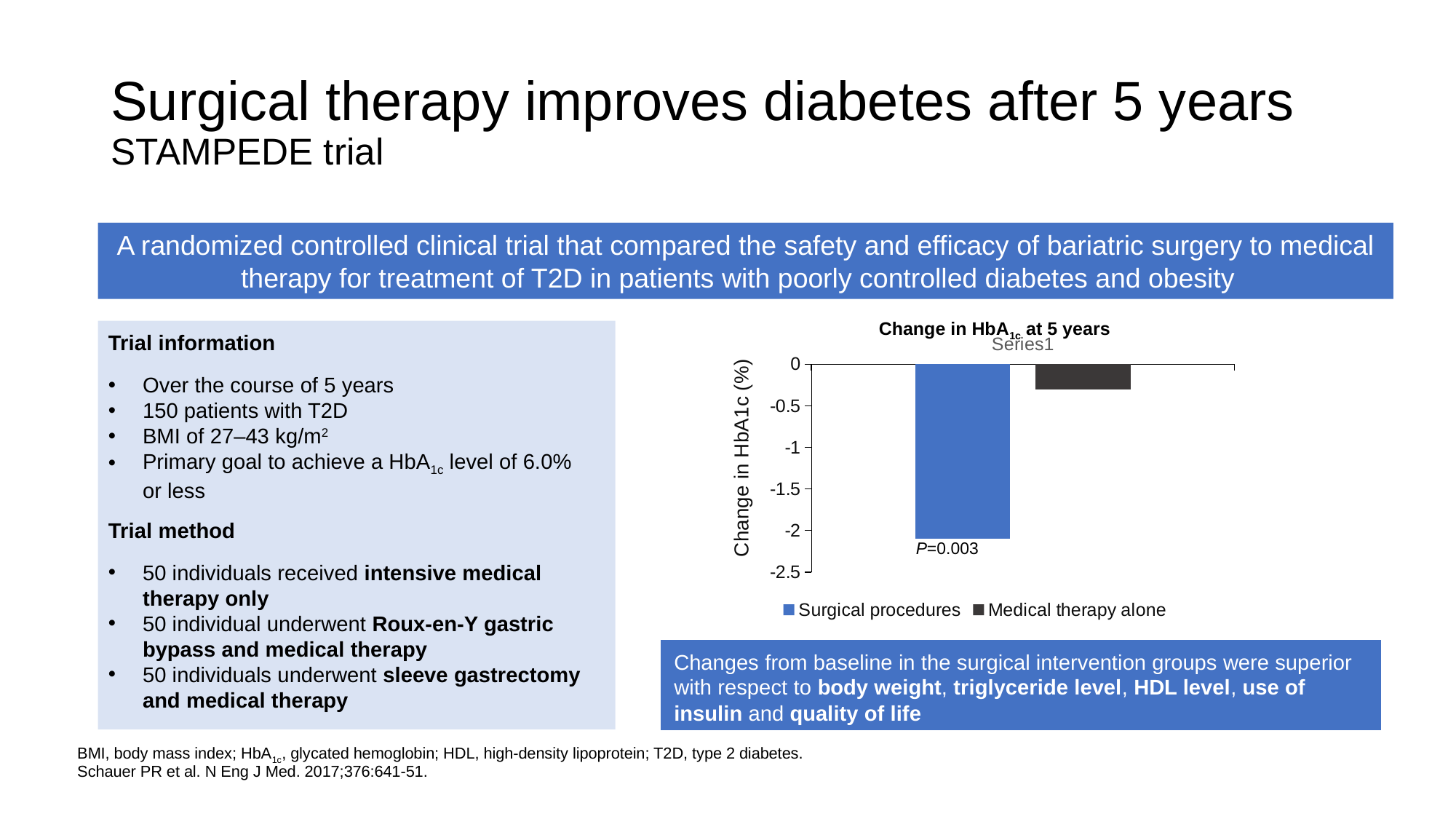
What is the title of the chart? Change in HbA1c at 5 years Which series in the chart shows the larger reduction in HbA1c? Surgical procedures What type of chart is shown on the slide? bar chart Is the value for Surgical procedures greater or less than -1? less How many series does the chart legend list? 2 Is the value for Surgical procedures greater or less than -2.5? greater Which series has the lowest (most negative) value in the chart? Surgical procedures What is the label of the vertical axis of the chart? Change in HbA1c (%) Which series has the highest value (closest to zero) in the chart? Medical therapy alone How many bars are plotted in the chart? 2 Is the value for Medical therapy alone greater or less than -0.5? greater